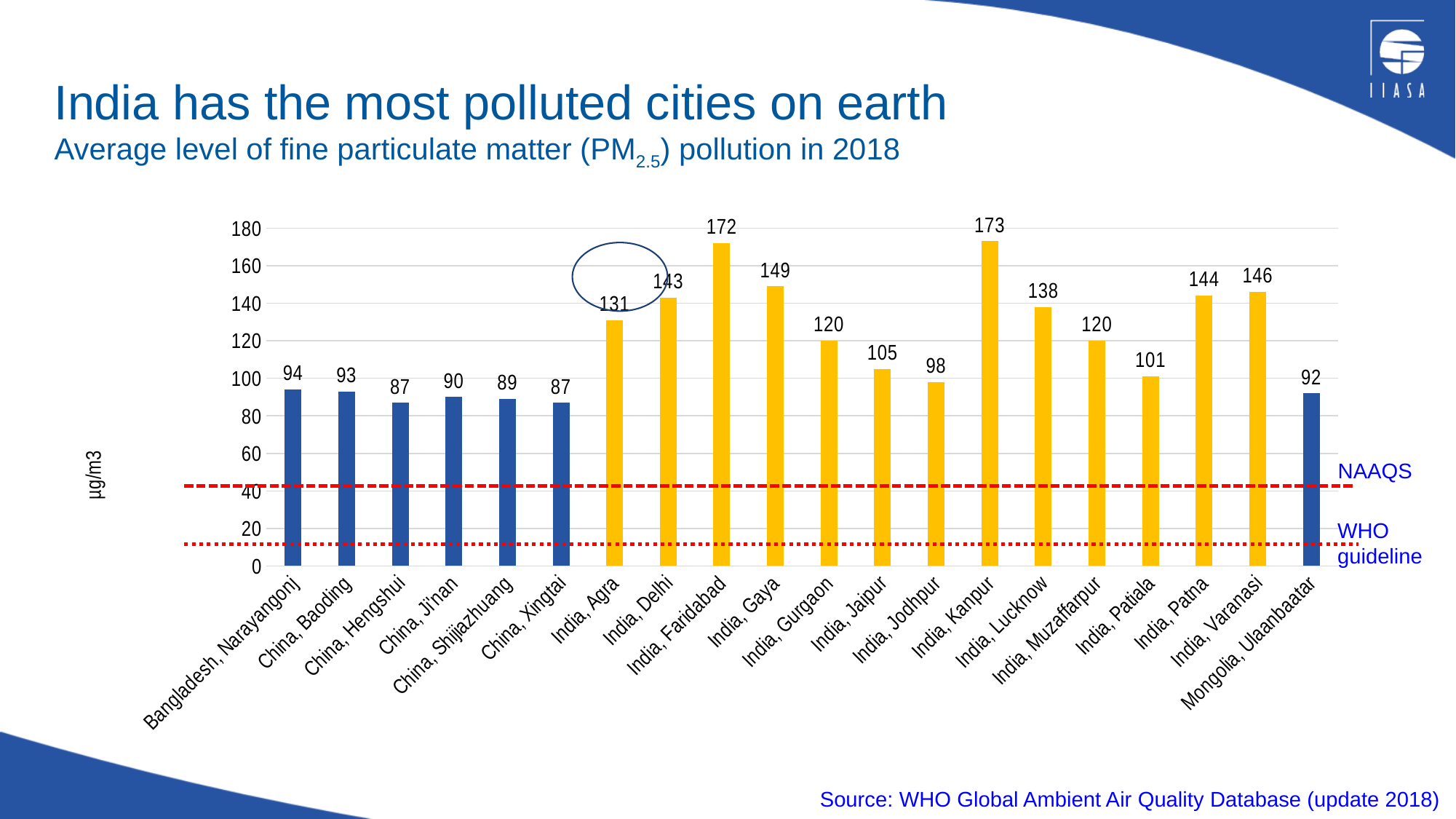
What is the PM2.5 value for Mongolia, Ulaanbaatar? 92 What is the PM2.5 value for India, Delhi? 143 What is the PM2.5 value for India, Gurgaon? 120 What kind of chart is shown on the slide? Bar chart Which has a higher value, India, Patna or India, Varanasi? India, Varanasi Which city has the highest PM2.5 value in the chart? India, Kanpur How many cities are shown in the chart? 20 What unit is shown on the y axis of the chart? µg/m3 What is the difference between the values for India, Delhi and China, Baoding? 50 What is the difference between the values for India, Faridabad and India, Agra? 41 What is the PM2.5 value for India, Kanpur? 173 What are the two horizontal reference lines in the chart labelled? NAAQS and WHO guideline